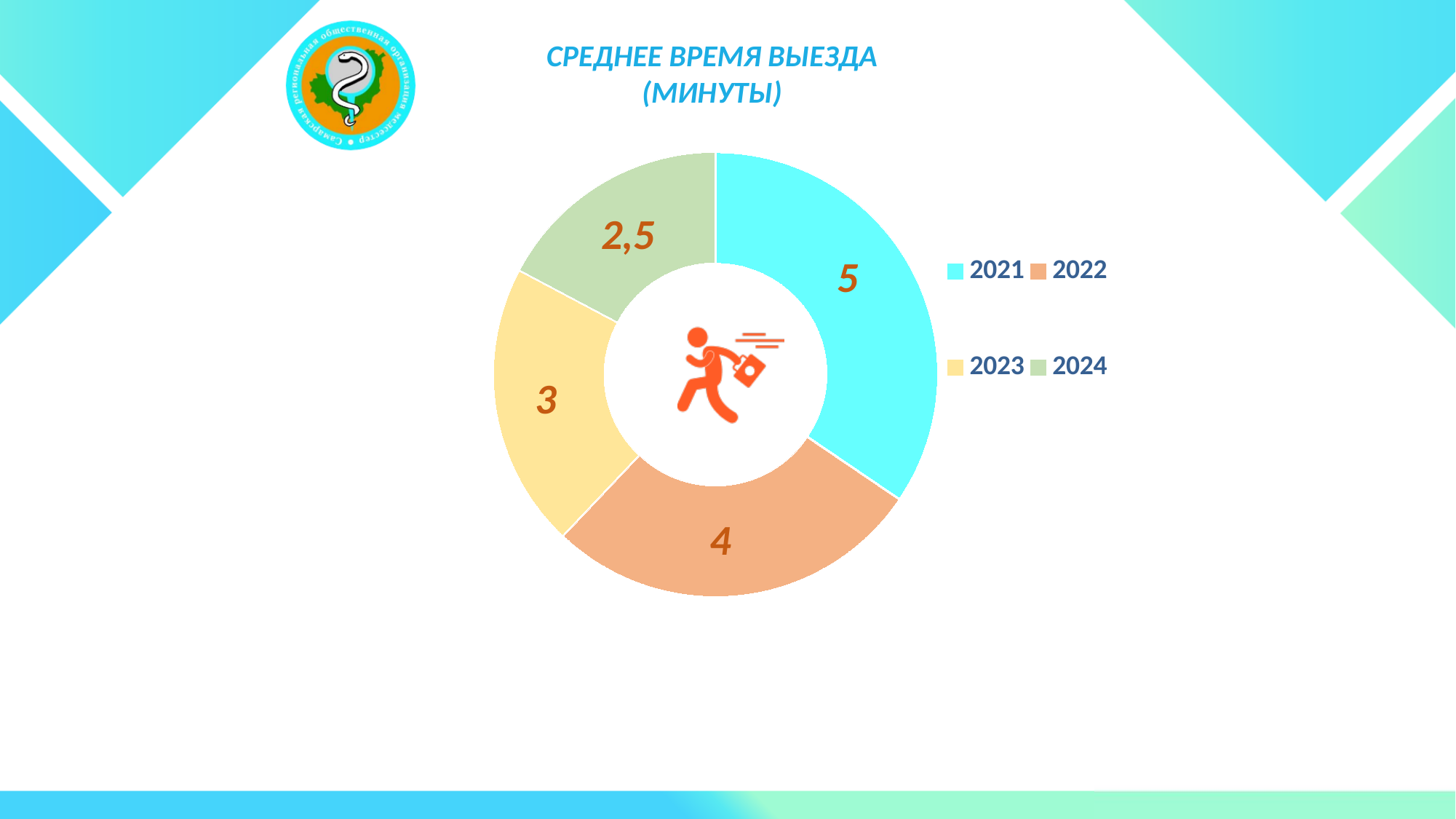
Which year has the highest average departure time? 2021 What is the value for 2024 in the chart? 2,5 What is the difference between the values for 2023 and 2024? 0,5 What kind of chart is shown on the slide? Doughnut chart What is the value for 2021 in the chart? 5 Which year has the lowest average departure time? 2024 What is the value for 2023 in the chart? 3 What is the title of the chart? СРЕДНЕЕ ВРЕМЯ ВЫЕЗДА (МИНУТЫ) How many years (categories) are shown in the chart? 4 Which is larger, the value for 2022 or the value for 2023? 2022 Which colour represents 2022 in the legend? Orange What is the difference between the values for 2021 and 2022? 1